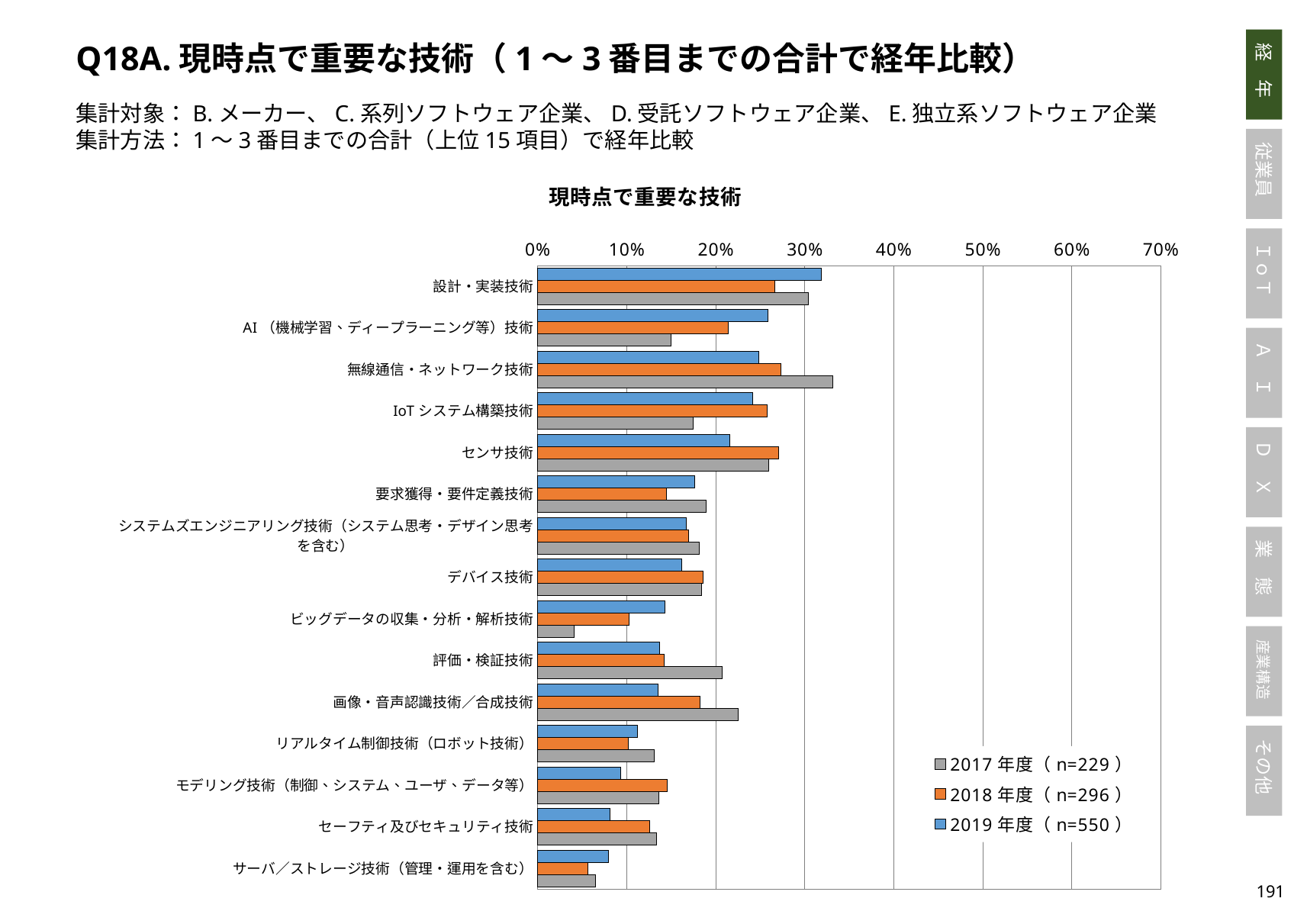
How many series does the legend list? 3 What kind of chart is shown on the slide? bar chart What is the sample size (n) shown in the legend for the 2019年度 series? n=550 Which category has the highest value for the 2017年度 series? 無線通信・ネットワーク技術 Which category has the lowest value for the 2017年度 series? ビッグデータの収集・分析・解析技術 Is the 2019年度 value for 設計・実装技術 greater or less than 30%? greater Is the 2017年度 value for ビッグデータの収集・分析・解析技術 greater or less than 10%? less Is the 2019年度 value for AI（機械学習、ディープラーニング等）技術 greater or less than 20%? greater How many technology categories are plotted in the chart? 15 Which category has the lowest value for the 2018年度 series? サーバ／ストレージ技術（管理・運用を含む） For AI（機械学習、ディープラーニング等）技術, which is larger: the 2019年度 value or the 2017年度 value? 2019年度 Which category has the highest value for the 2019年度 series? 設計・実装技術